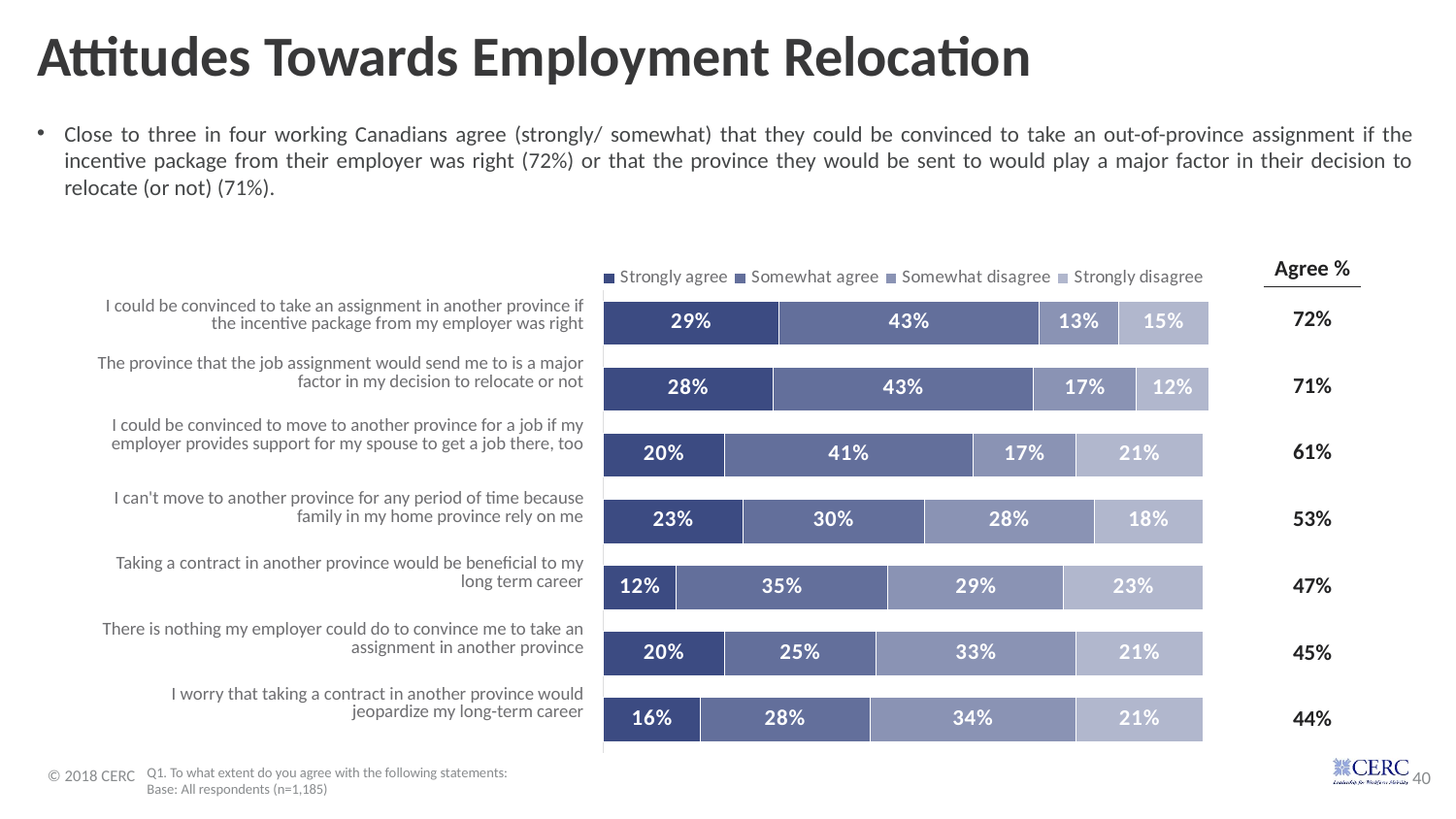
Which is larger: the Somewhat disagree share for 'I worry that taking a contract in another province would jeopardize my long-term career' or for 'Taking a contract in another province would be beneficial to my long term career'? I worry that taking a contract in another province would jeopardize my long-term career (34%) What is the difference in Agree % between the incentive package statement (72%) and the statement that there is nothing the employer could do to convince them (45%)? 27 percentage points What is the Agree % for the statement 'I worry that taking a contract in another province would jeopardize my long-term career'? 44% What percentage of respondents strongly disagree that they can't move to another province because family in their home province rely on them? 18% What is the combined Strongly agree and Somewhat agree percentage for the statement about the employer providing support for a spouse to get a job? 61% Which statement has the highest Agree %? I could be convinced to take an assignment in another province if the incentive package from my employer was right What kind of chart is shown on the slide? Stacked bar chart How many series does the legend list? 4 What percentage of respondents strongly agree that they could be convinced to take an assignment in another province if the incentive package from their employer was right? 29% Which statement has the lowest Strongly agree percentage? Taking a contract in another province would be beneficial to my long term career How many statements are shown in the chart? 7 What percentage of respondents somewhat disagree that the province the job assignment would send them to is a major factor in their decision to relocate or not? 17%